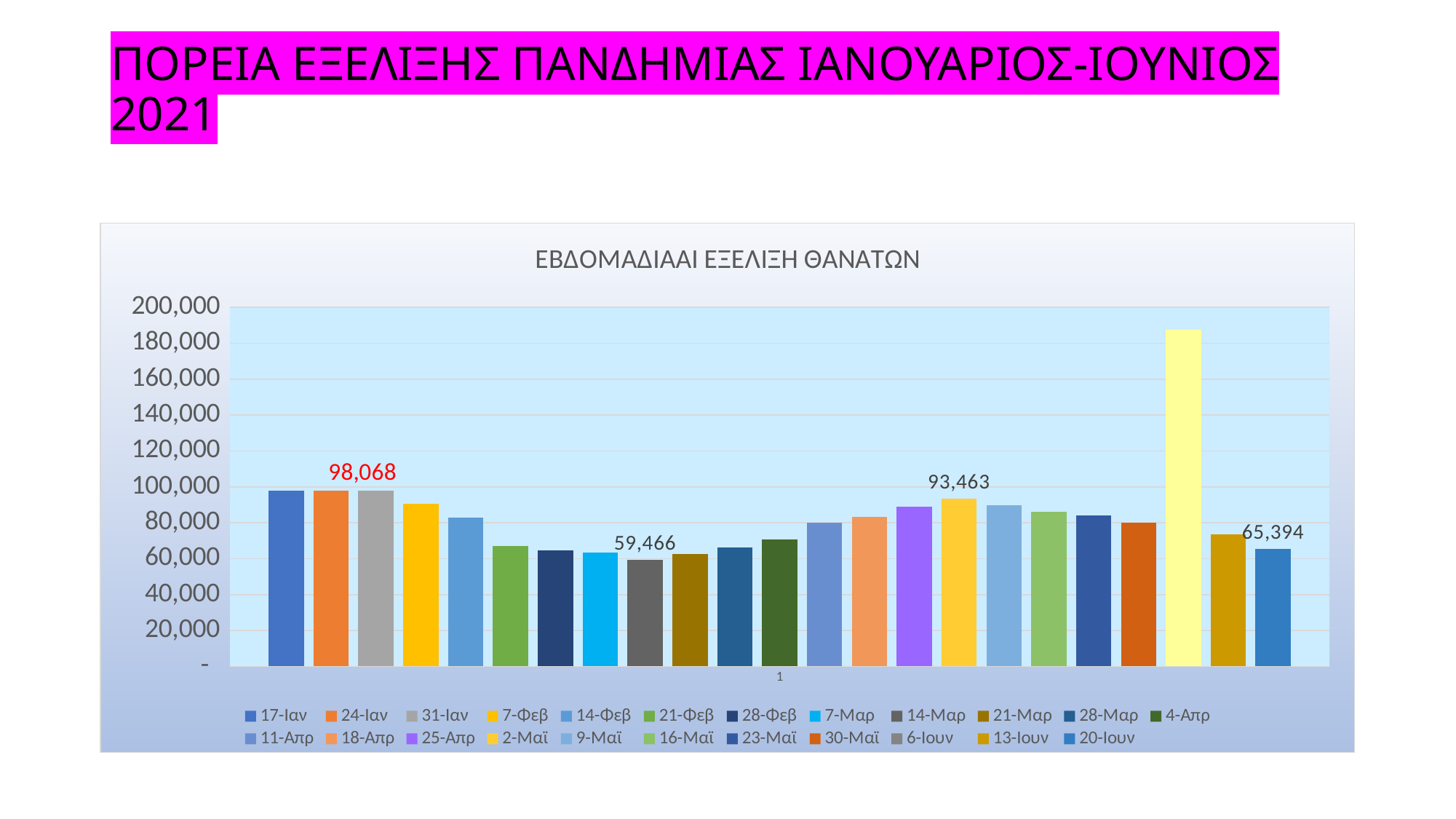
Which is larger, the value for 2-Μαϊ or the value for 20-Ιουν? 2-Μαϊ Which week has the lowest bar? 14-Μαρ What is the value for 24-Ιαν? 98,068 What is the difference between the values for 24-Ιαν and 14-Μαρ? 38,602 Is the value for 6-Ιουν greater or less than 180,000? greater What is the value for 2-Μαϊ? 93,463 What type of chart is shown on the slide? bar chart What is the title of the chart? ΕΒΔΟΜΑΔΙΑΑΙ ΕΞΕΛΙΞΗ ΘΑΝΑΤΩΝ What is the value for 14-Μαρ? 59,466 How many series does the legend list? 23 Which week has the highest bar? 6-Ιουν What is the value for 20-Ιουν? 65,394